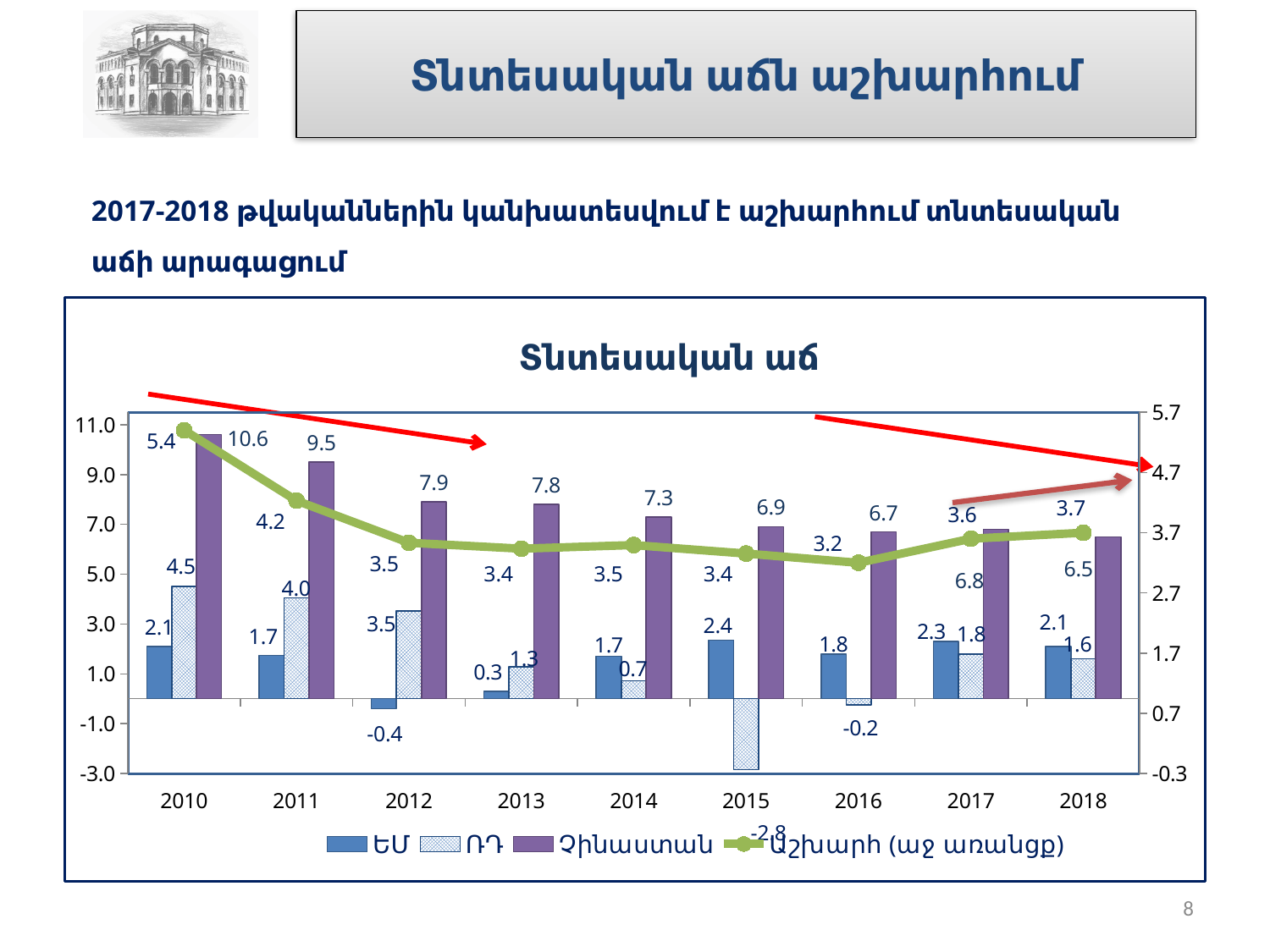
In which year is the value for Չինաստան the highest? 2010 What is the value for ԵՄ in 2012? -0.4 What is the difference between the Չինաստան values in 2010 and 2018? 4.1 How many series does the legend list? 4 Does the Չինաստան series rise or fall from 2010 to 2016? fall What is the value for ՌԴ in 2015? -2.8 What is the title of the chart? Տնտեսական աճ What is the value of the Աշխարհ (աջ առանցք) line in 2018? 3.7 How many years are shown on the x axis? 9 What is the value for Չինաստան in 2010? 10.6 In which year is the value for ՌԴ the lowest? 2015 Which is larger in 2017, the value for ԵՄ or the value for ՌԴ? ԵՄ